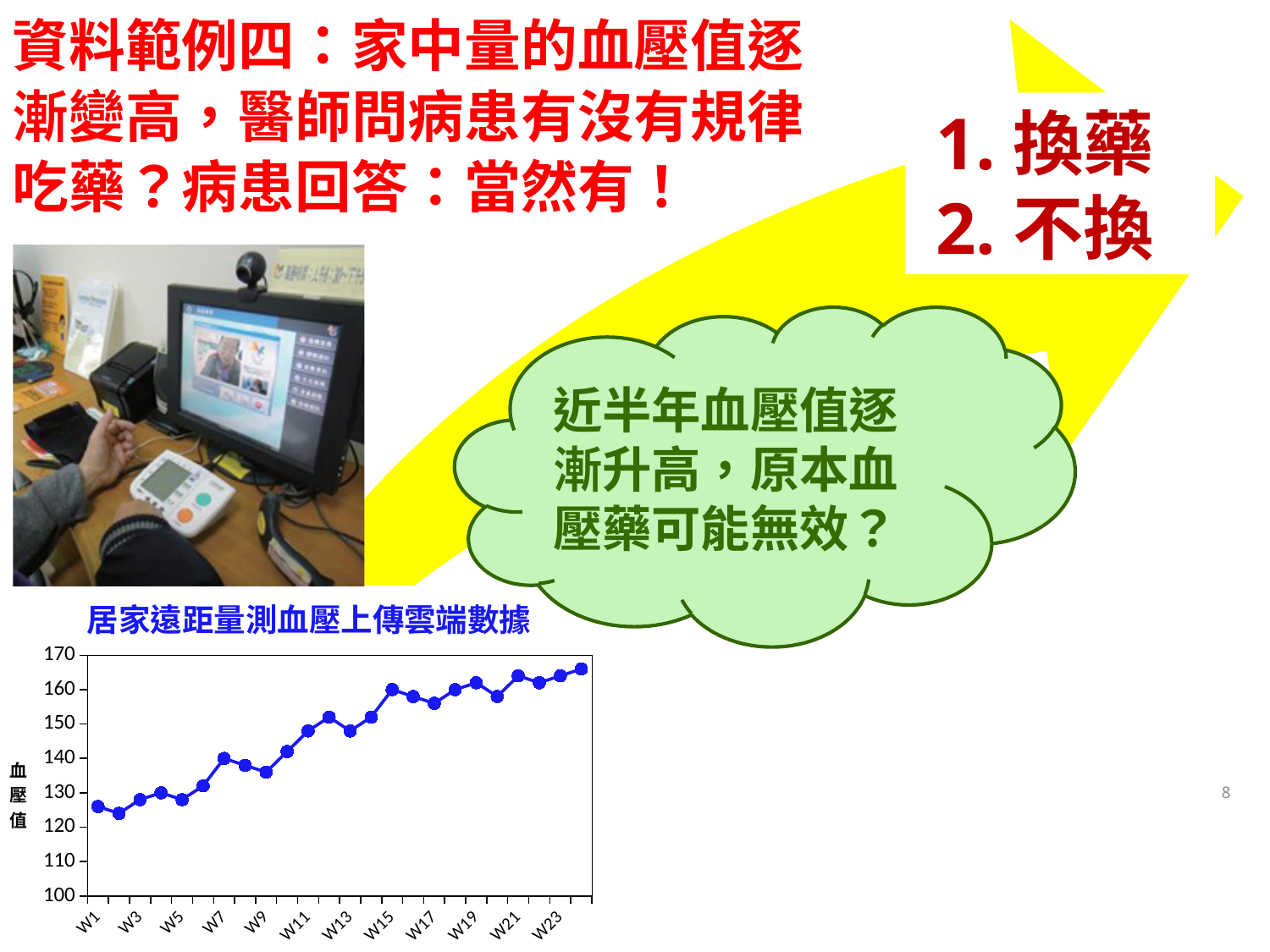
What kind of chart is shown on the slide? line chart Which is larger, the value for W5 or the value for W15? W15 Is the value for W24 greater or less than 160? greater Is the value for W7 greater or less than 130? greater What is the title of the chart? 居家遠距量測血壓上傳雲端數據 How many data points are plotted on the line? 24 What is the label on the vertical axis of the chart? 血壓值 Is the value for W15 greater or less than 150? greater Which is larger, the value for W1 or the value for W24? W24 Do the blood pressure values generally rise or fall from W1 to W24? rise